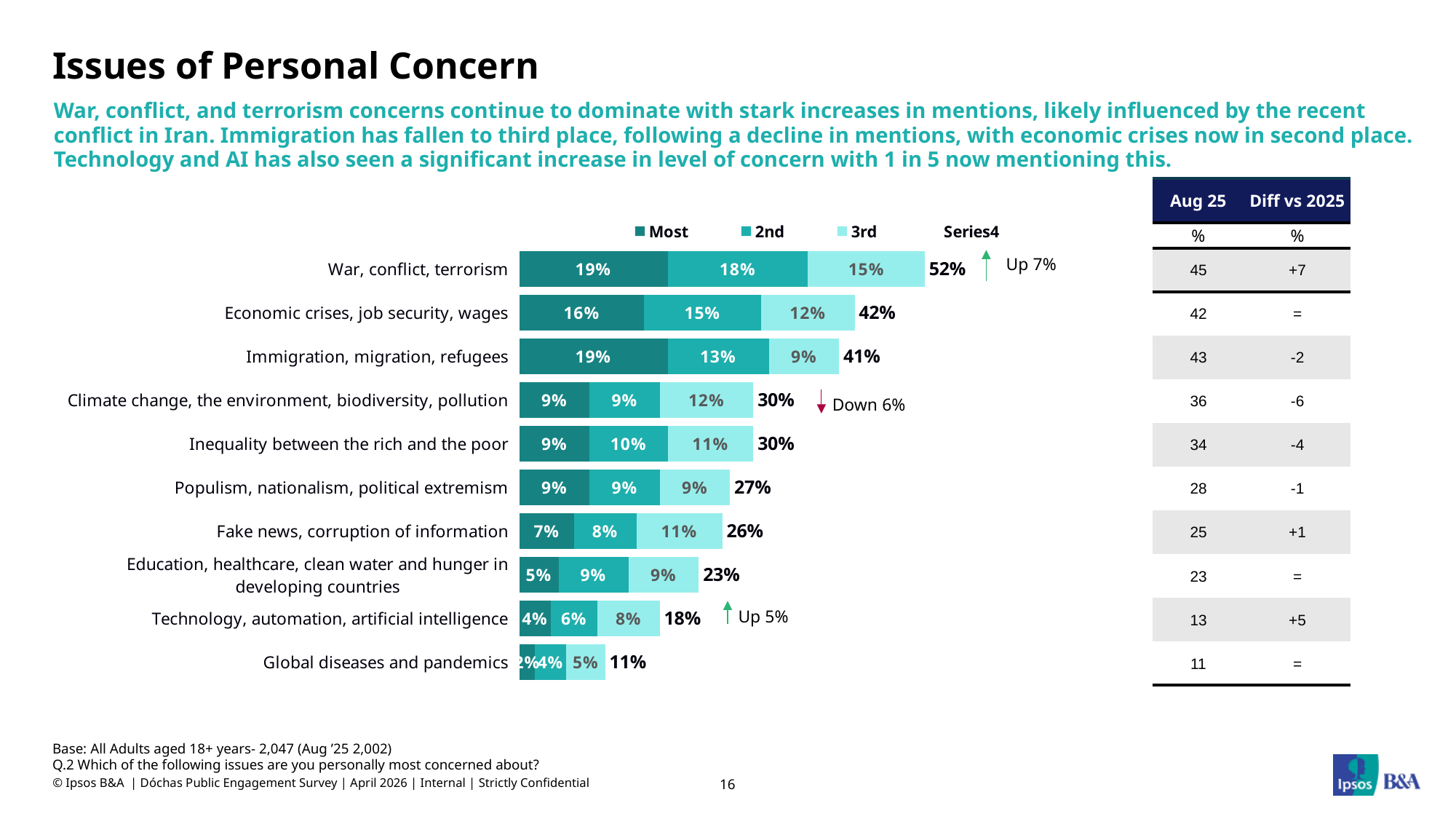
How many issues are shown in the chart? 10 Which has the larger total: Technology, automation, artificial intelligence or Education, healthcare, clean water and hunger in developing countries? Education, healthcare, clean water and hunger in developing countries Which issue has the highest total? War, conflict, terrorism Which issue has the lowest total? Global diseases and pandemics What kind of chart is shown? Stacked bar chart What is the "2nd" value for Economic crises, job security, wages? 15% How many series does the legend list? 4 What is the difference between the totals for Economic crises, job security, wages and Immigration, migration, refugees? 1% What is the "3rd" value for Immigration, migration, refugees? 9% What is the total for the War, conflict, terrorism bar? 52% What is the "Most" value for War, conflict, terrorism? 19% What is the "3rd" value for Climate change, the environment, biodiversity, pollution? 12%